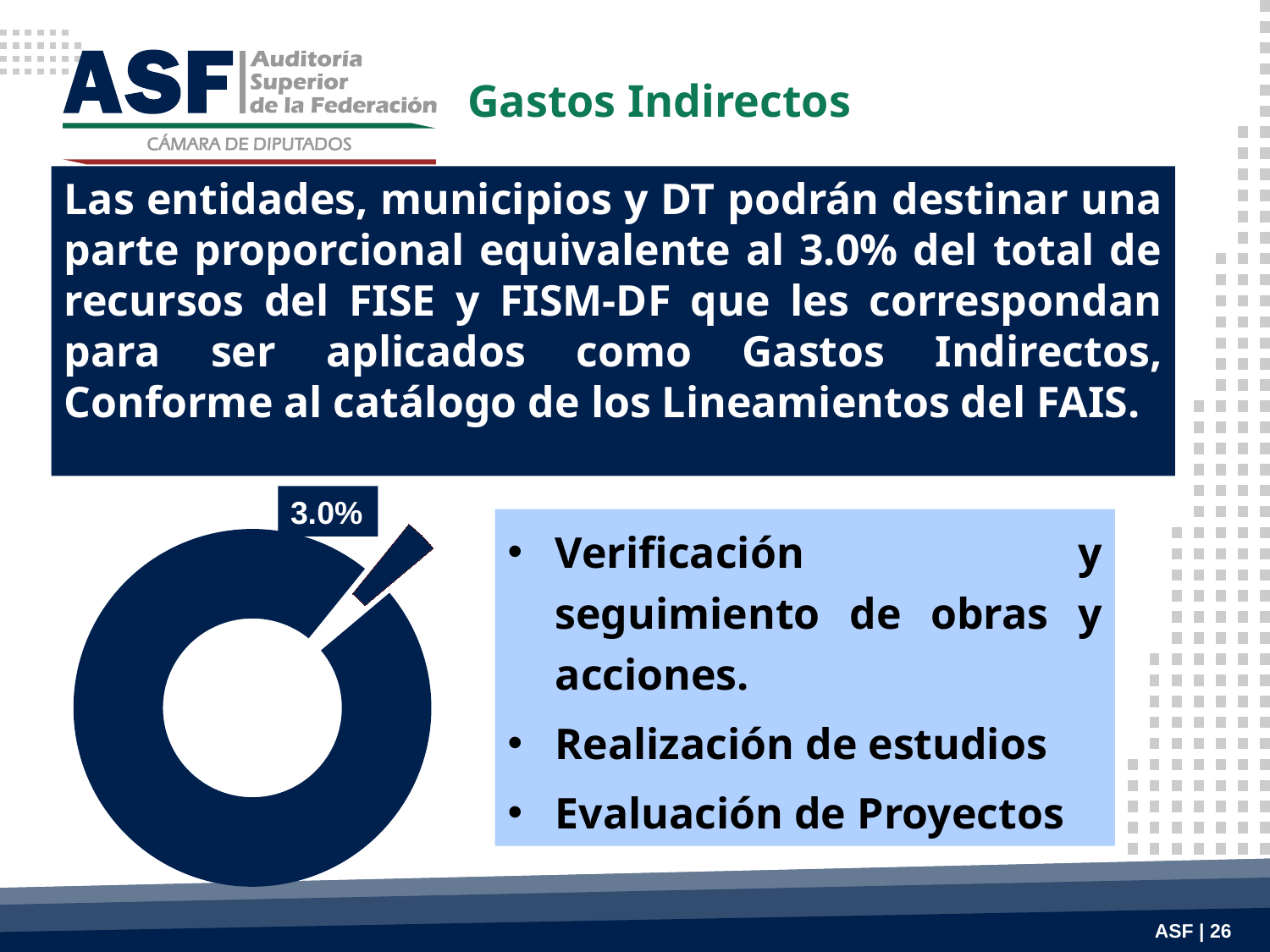
What kind of chart is shown on the slide? doughnut chart How many data labels are printed on the doughnut chart? 1 Is the exploded slice of the doughnut chart the smallest or the largest slice? smallest What colour are the slices of the doughnut chart? dark navy blue What value is printed as the data label on the exploded slice of the doughnut chart? 3.0% How many slices does the doughnut chart have? 2 What share of the doughnut does the exploded slice represent? 3.0% Which slice of the doughnut chart is larger, the exploded slice or the remaining ring? the remaining ring